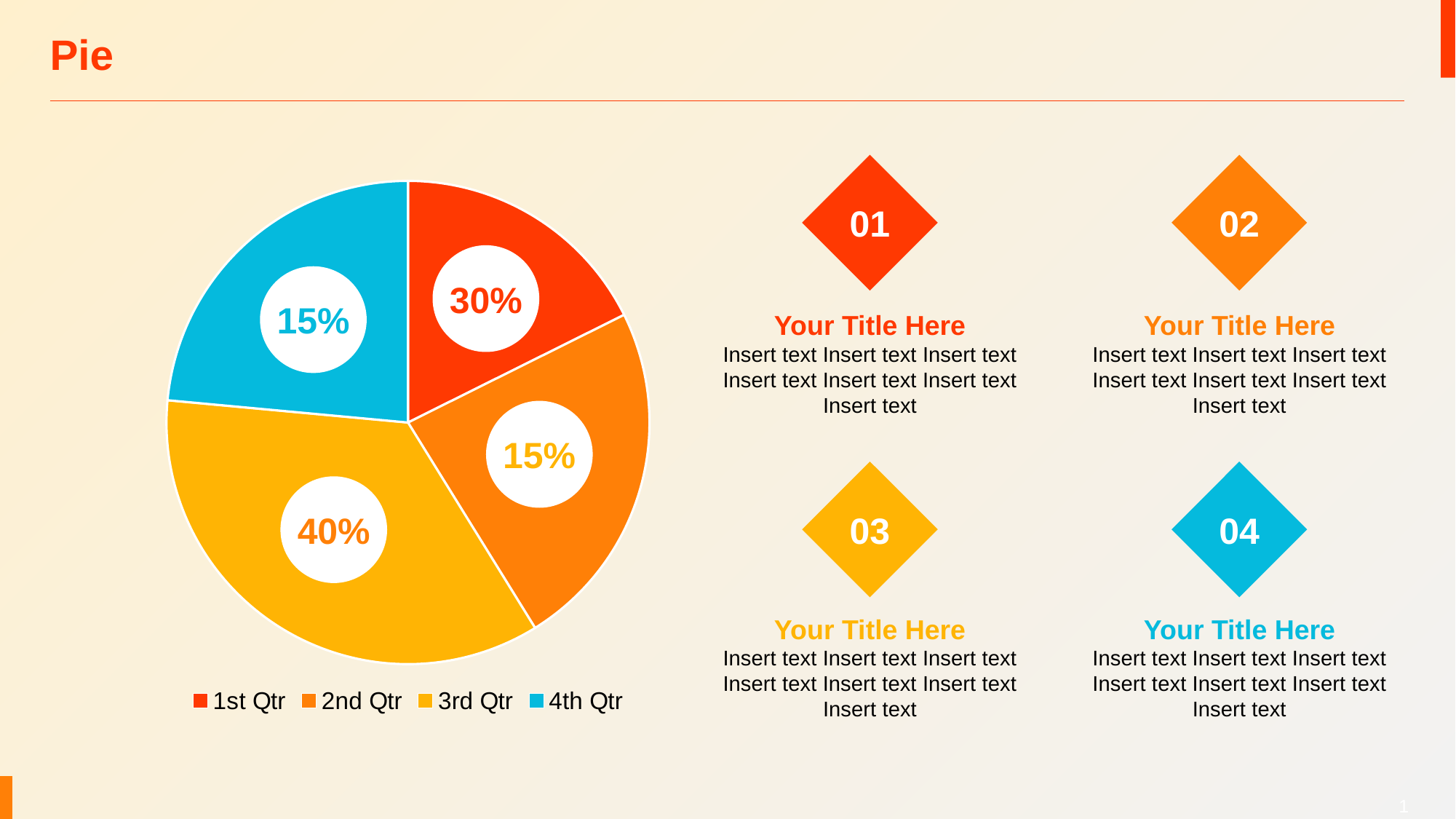
Which category has the largest slice in the pie chart? 3rd Qtr What is the title of the slide? Pie What kind of chart is shown on the slide? pie chart What colour is the 4th Qtr slice in the pie chart? blue How many entries does the legend list? 4 How many categories does the pie chart have? 4